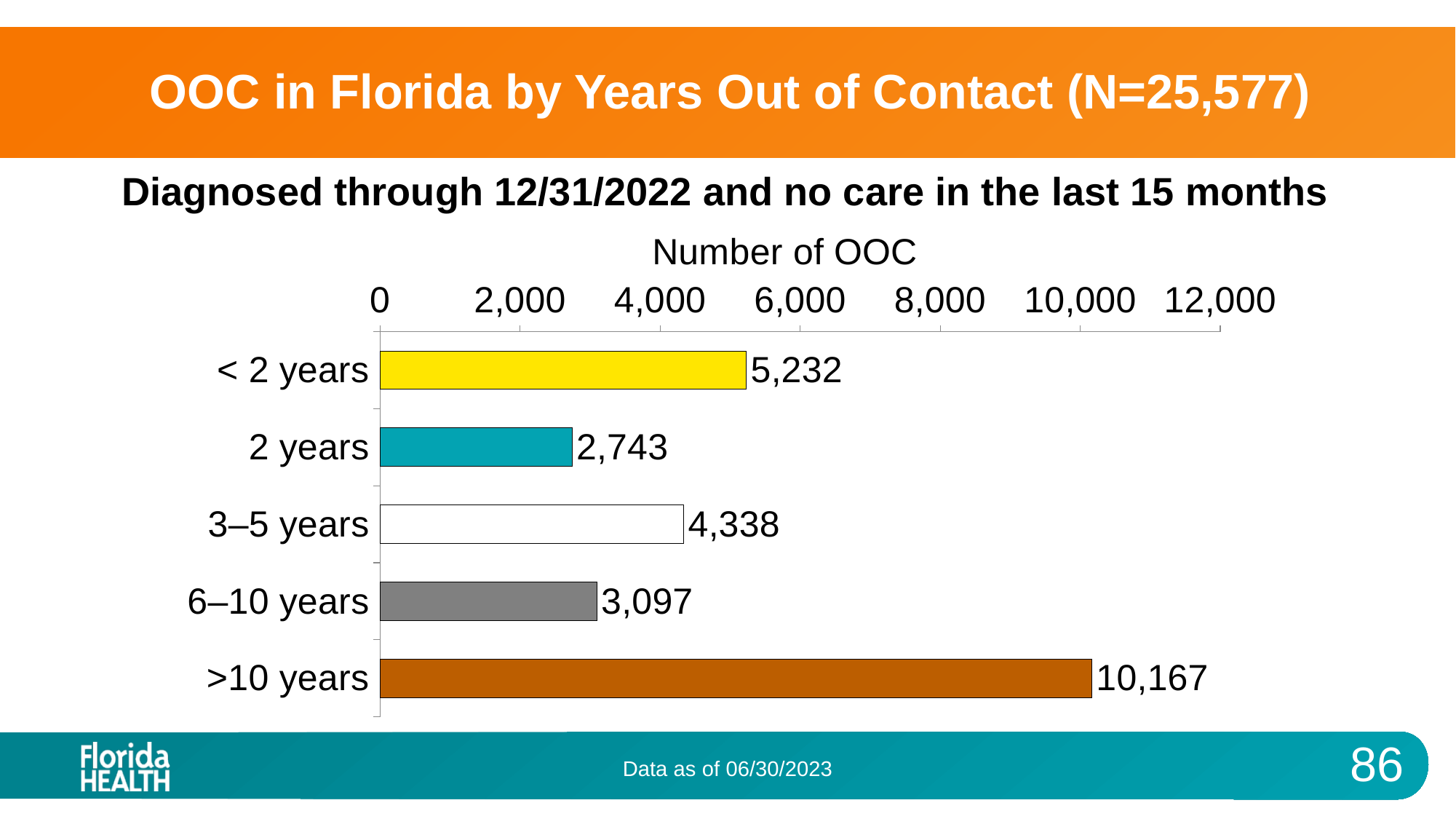
What kind of chart is shown on the slide? Bar chart What is the difference in number of OOC between the >10 years and < 2 years categories? 4,935 What is the title of the horizontal axis of the chart? Number of OOC Which years-out-of-contact category has the highest number of OOC? >10 years Is the value for >10 years greater or less than 10,000? greater How many years-out-of-contact categories are shown in the chart? 5 Which has a larger number of OOC, 3–5 years or 6–10 years? 3–5 years What is the number of OOC for the < 2 years category? 5,232 Which years-out-of-contact category has the lowest number of OOC? 2 years What is the number of OOC for the 6–10 years category? 3,097 What is the difference in number of OOC between the 3–5 years and 2 years categories? 1,595 What is the number of OOC for the >10 years category? 10,167